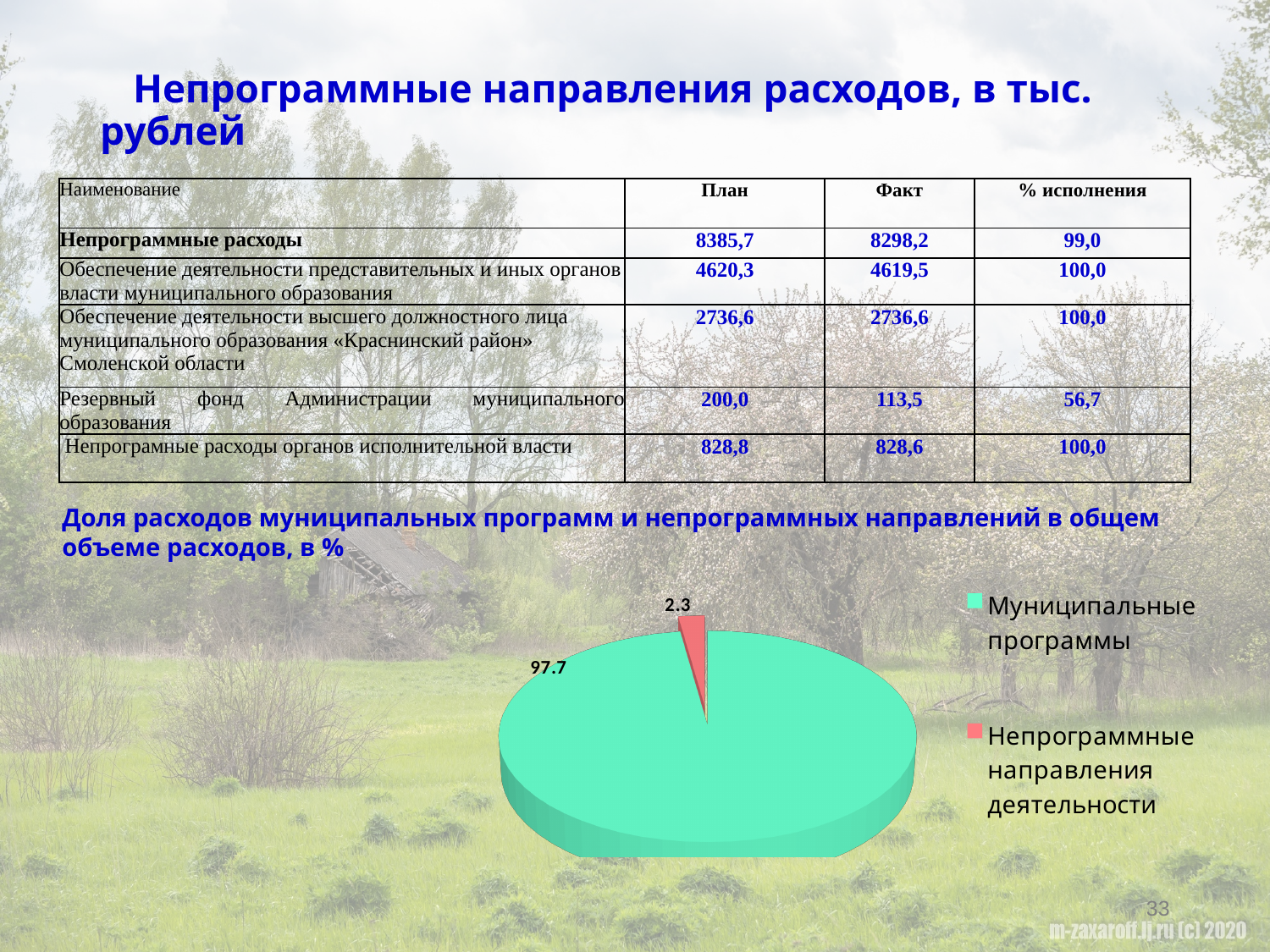
What kind of chart is shown on the slide? Pie chart What is the total of the two values shown in the pie chart? 100 Which slice of the pie chart is the largest? Муниципальные программы What is the value shown for Непрограммные направления деятельности in the pie chart? 2.3 Which slice of the pie chart is the smallest? Непрограммные направления деятельности How many entries does the legend of the pie chart list? 2 What is the value shown for Муниципальные программы in the pie chart? 97.7 What colour is the slice for Непрограммные направления деятельности in the pie chart? Red Which is larger in the pie chart: Муниципальные программы or Непрограммные направления деятельности? Муниципальные программы How many slices does the pie chart have? 2 What colour is the slice for Муниципальные программы in the pie chart? Green What is the difference between the values for Муниципальные программы and Непрограммные направления деятельности in the pie chart? 95.4